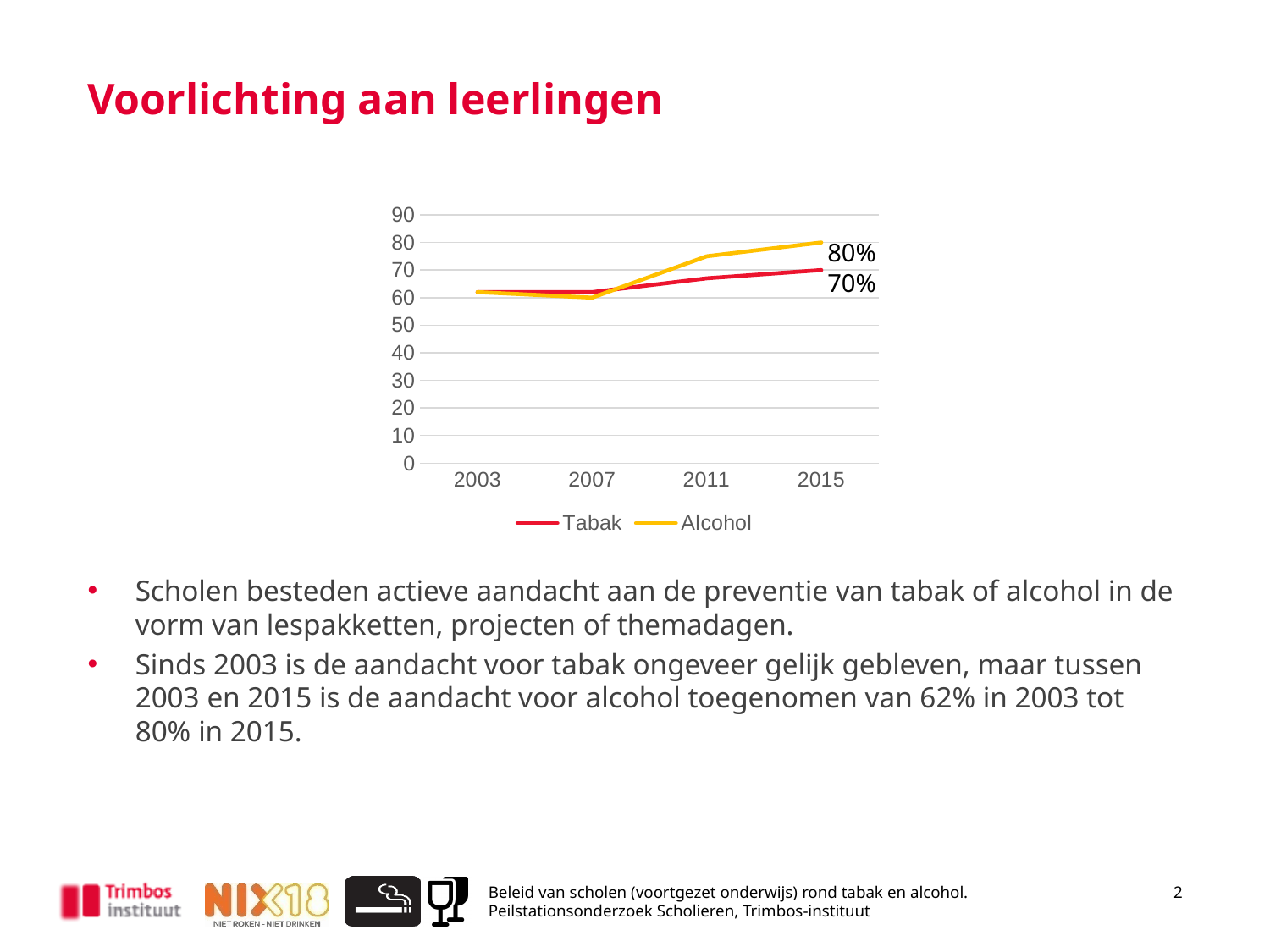
In 2015, which series has the larger value, Tabak or Alcohol? Alcohol What kind of chart is shown on the slide? Line chart Is the value for Tabak in 2003 greater or less than 70? less How many series does the legend list? 2 Is the value for Alcohol in 2011 greater or less than 70? greater What is the value for Tabak in 2015? 70% What is the value for Alcohol in 2015? 80% Does the Alcohol line rise or fall from 2003 to 2015? Rise How many years are shown on the x axis? 4 Is the value for Alcohol in 2007 greater or less than 70? less In which year does the Alcohol series reach its highest value? 2015 What is the difference between the Alcohol and Tabak values in 2015? 10%